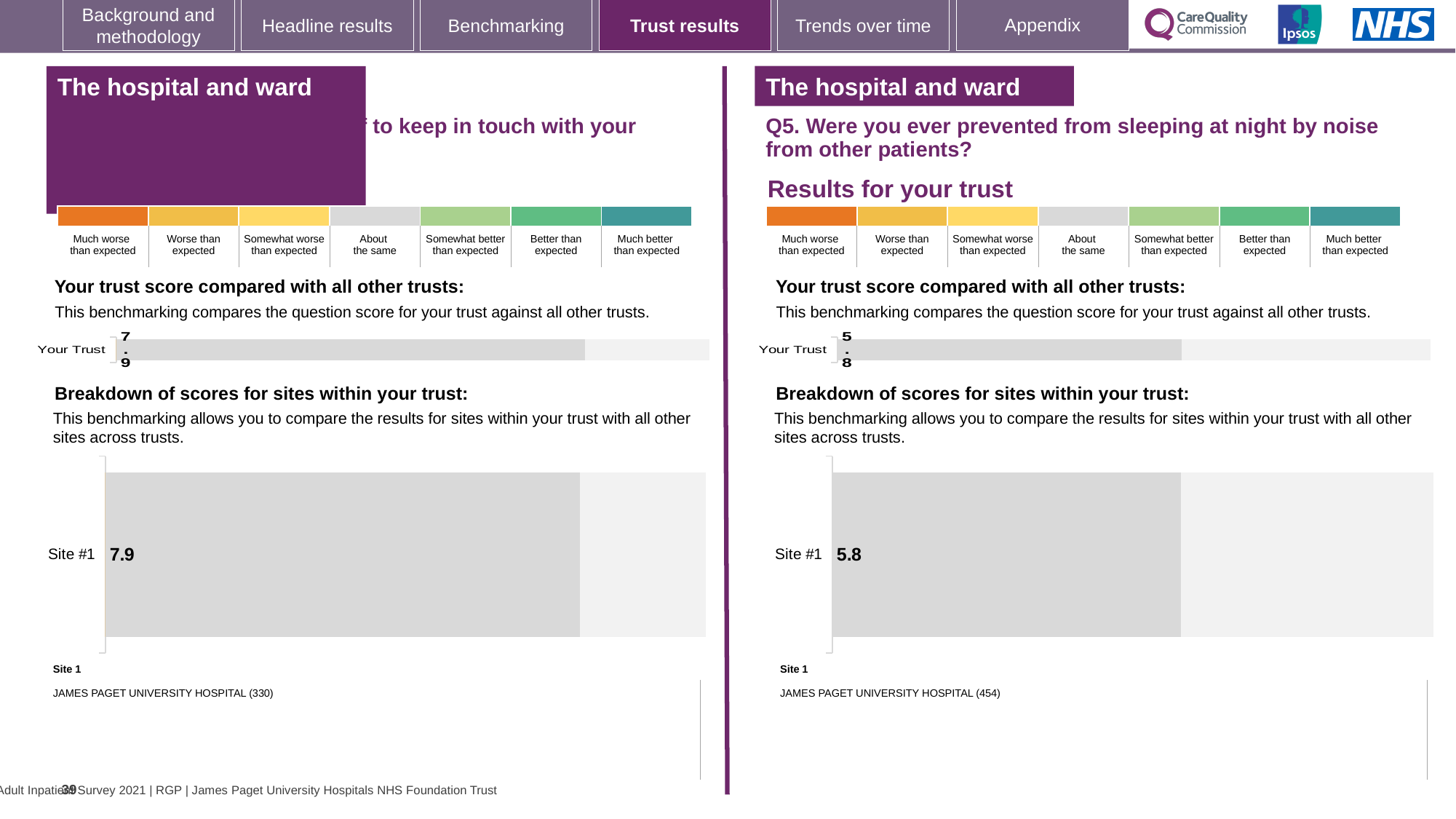
How many sites are shown in the breakdown of scores chart on the right-hand panel (Q5)? 1 What type of chart is used to show the Site #1 score on the left-hand panel? Bar chart On the left-hand panel, what is the score shown for Your Trust in the trust score comparison chart? 7.9 Is the Your Trust score on the right-hand panel (Q5) greater or less than the Your Trust score on the left-hand panel? less What is the difference between the Site #1 score on the left-hand panel (7.9) and the Site #1 score on the right-hand panel (5.8)? 2.1 Which is larger: the Your Trust score on the left-hand panel or the Your Trust score on the right-hand panel (Q5)? Left-hand panel (7.9) On the right-hand panel (Q5), which site name is listed as Site 1 below the breakdown chart? JAMES PAGET UNIVERSITY HOSPITAL (454) On the left-hand panel, what number in brackets follows the Site 1 name JAMES PAGET UNIVERSITY HOSPITAL? 330 On the right-hand panel (Q5), what score is shown for Site #1 in the breakdown of scores for sites within your trust? 5.8 On the right-hand panel (Q5, prevented from sleeping by noise from other patients), what is the score shown for Your Trust? 5.8 On the left-hand panel, what score is shown for Site #1 in the breakdown of scores for sites within your trust? 7.9